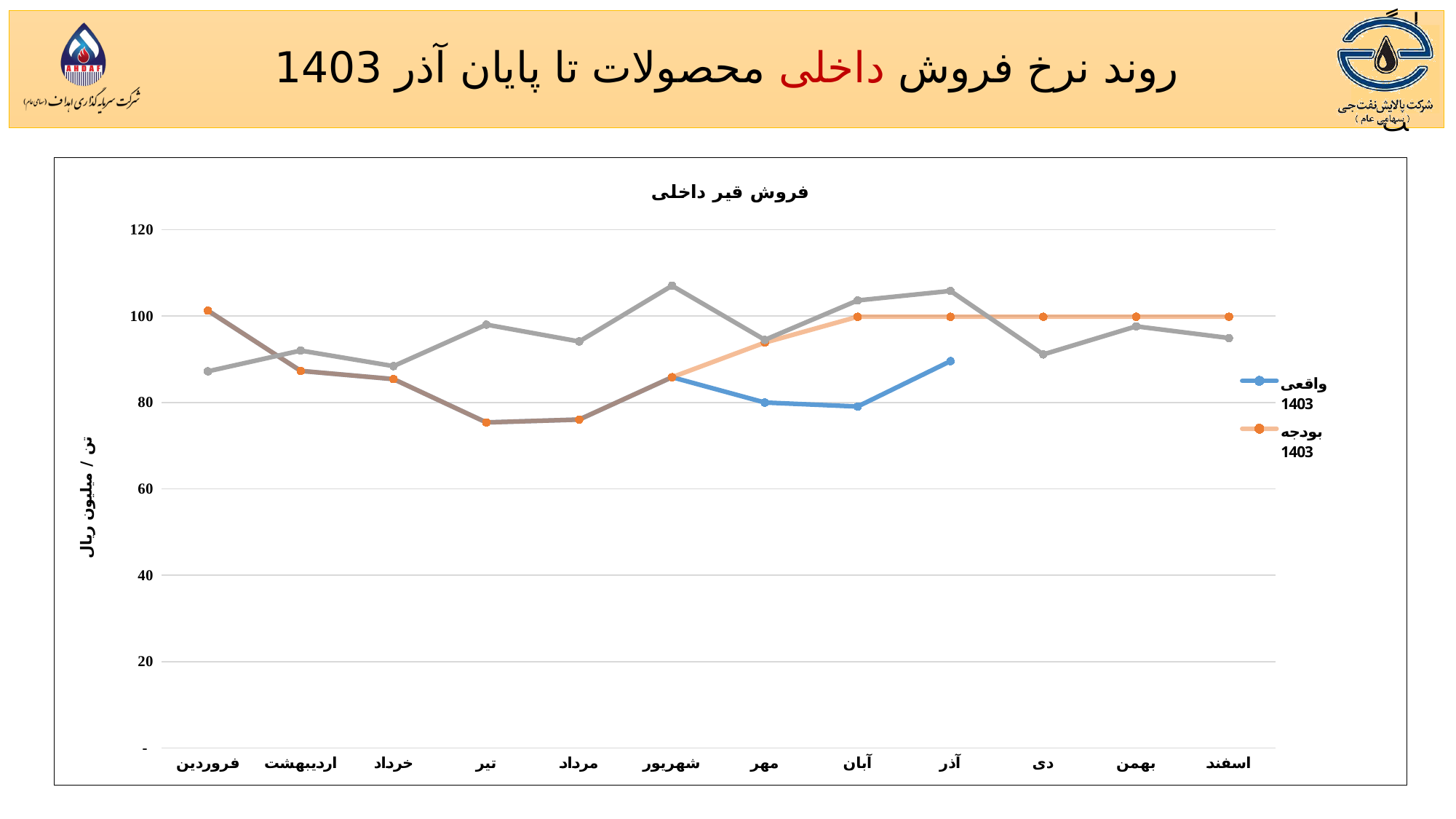
For آبان, which is larger: واقعی 1403 or بودجه 1403? بودجه 1403 What is the label on the vertical axis? تن / میلیون ریال How many months are shown on the x axis? 12 Is the value of بودجه 1403 for تیر greater or less than 80? less Is the value of واقعی 1403 for آبان greater or less than 100? less What kind of chart is shown on the slide? line chart Is the value of واقعی 1403 for آذر greater or less than 80? greater For بودجه 1403, which is larger: the value for فروردین or the value for تیر? فروردین How many series does the legend list? 2 What is the title of the chart? فروش قیر داخلی Does the بودجه 1403 line rise, fall or stay flat from آبان to اسفند? stays flat